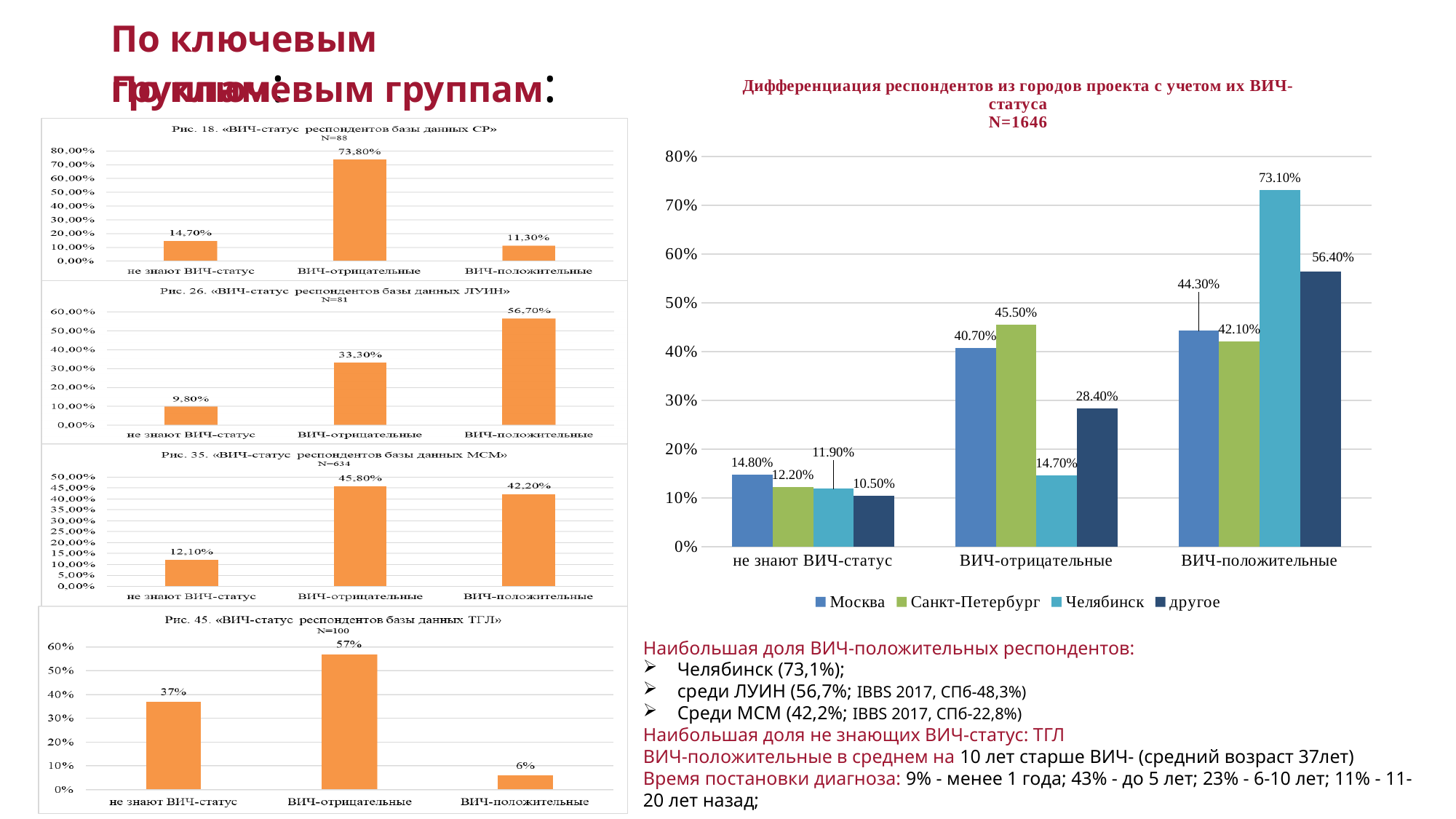
In the chart titled «Рис. 45. «ВИЧ-статус респондентов базы данных ТГЛ»», what is the value for ВИЧ-положительные? 6% In the chart titled «Дифференциация респондентов из городов проекта с учетом их ВИЧ-статуса», which is larger in the ВИЧ-положительные category: Москва or Санкт-Петербург? Москва In the chart titled «Рис. 26. «ВИЧ-статус респондентов базы данных ЛУИН»», which category has the lowest value? не знают ВИЧ-статус In the chart titled «Дифференциация респондентов из городов проекта с учетом их ВИЧ-статуса», how many series does the legend list? 4 In the chart titled «Рис. 18. «ВИЧ-статус респондентов базы данных СР»», what is the value for ВИЧ-отрицательные? 73,80% In the chart titled «Дифференциация респондентов из городов проекта с учетом их ВИЧ-статуса», which city has the highest value in the ВИЧ-отрицательные category? Санкт-Петербург What kind of chart is «Рис. 45. «ВИЧ-статус респондентов базы данных ТГЛ»»? bar chart In the chart titled «Рис. 26. «ВИЧ-статус респондентов базы данных ЛУИН»», how many categories are shown on the x axis? 3 In the chart titled «Дифференциация респондентов из городов проекта с учетом их ВИЧ-статуса», what is the value for Челябинск in the ВИЧ-положительные category? 73.10% In the chart titled «Дифференциация респондентов из городов проекта с учетом их ВИЧ-статуса», what is the value for другое in the ВИЧ-отрицательные category? 28.40% In the chart titled «Дифференциация респондентов из городов проекта с учетом их ВИЧ-статуса», what is the difference between Москва and другое in the не знают ВИЧ-статус category? 4.30% In the chart titled «Рис. 35. «ВИЧ-статус респондентов базы данных МСМ»», what is the difference between ВИЧ-отрицательные and ВИЧ-положительные? 3,60%